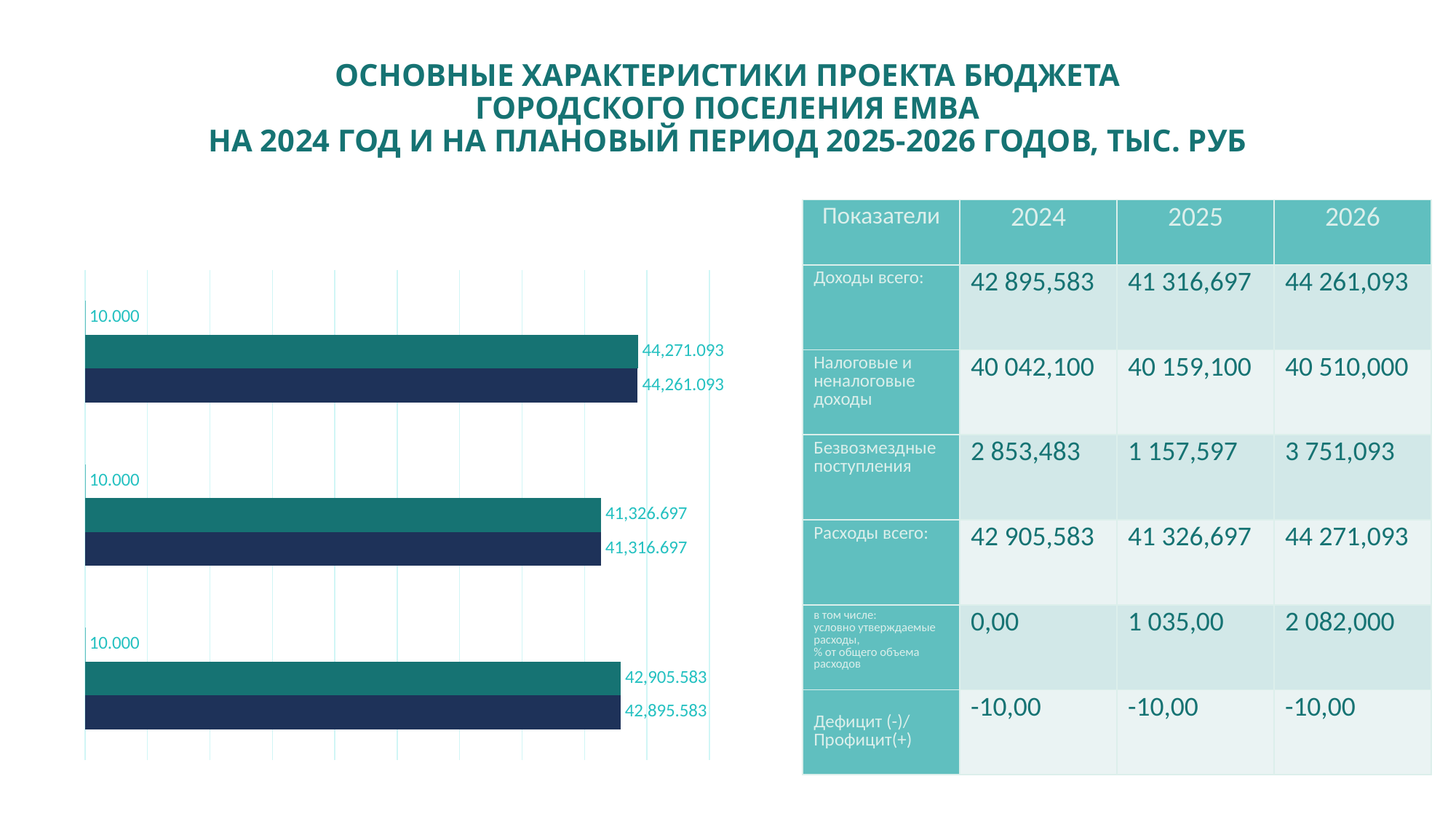
In the chart on the left, what value is labelled above the teal bar in each group? 10.000 In the chart on the left, what is the value labelled on the teal bar in the top group? 44,271.093 In the chart on the left, what is the difference between the teal bar in the top group and the teal bar in the middle group? 2,944.396 How many groups of bars does the chart on the left contain? 3 In the chart on the left, what is the value labelled on the teal bar in the middle group? 41,326.697 In the chart on the left, which group has the shortest dark navy bar: top, middle or bottom? middle In the chart on the left, what is the value labelled on the dark navy bar in the bottom group? 42,895.583 In the chart on the left, which is larger: the teal bar in the middle group or the teal bar in the bottom group? the teal bar in the bottom group In the chart on the left, what is the value labelled on the dark navy bar in the top group? 44,261.093 In the chart on the left, which group has the longest teal bar: top, middle or bottom? top What kind of chart is shown on the left of the slide? bar chart In the chart on the left, what is the difference between the teal bar and the dark navy bar in the bottom group? 10.000